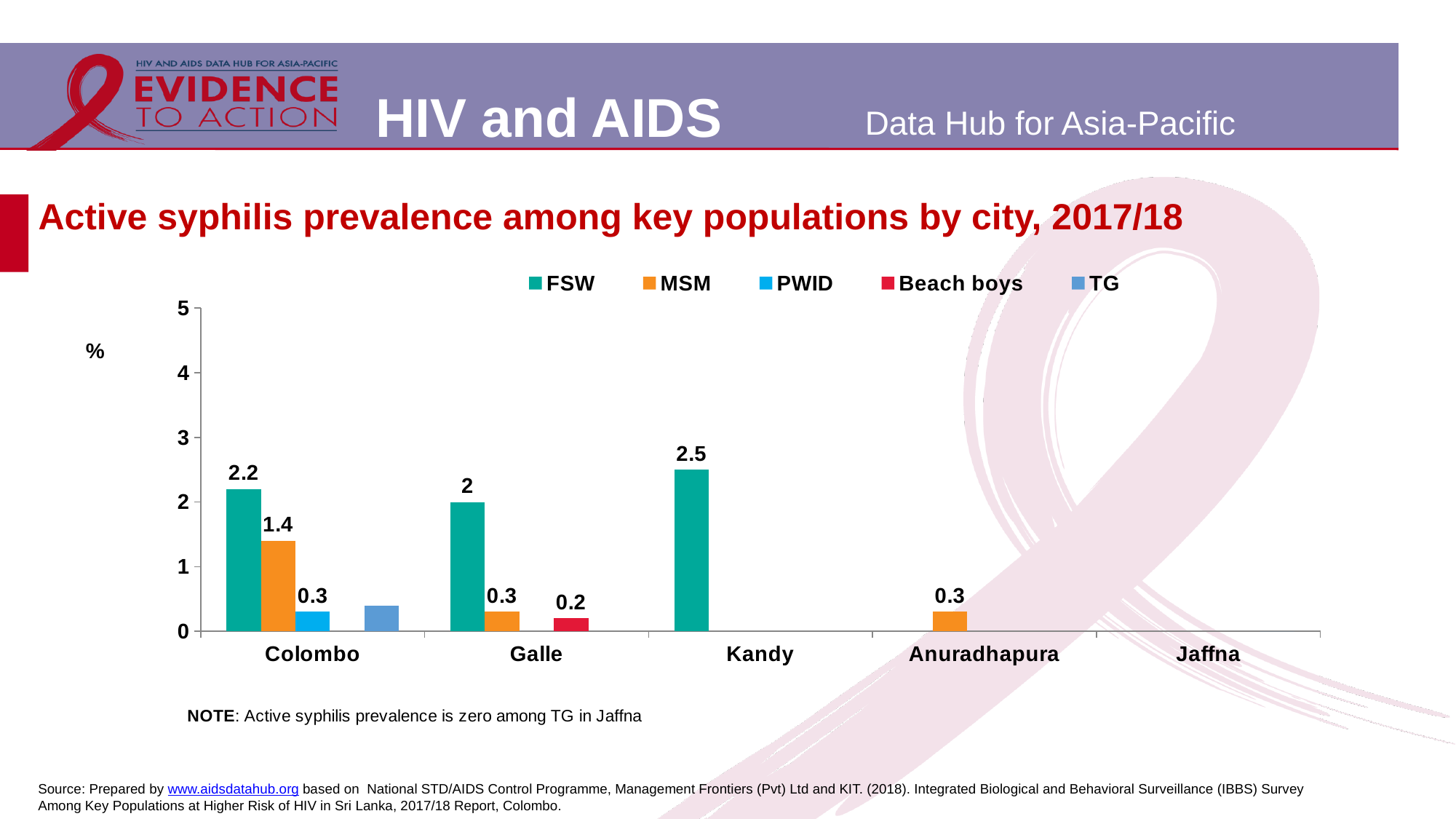
What is the title of the chart? Active syphilis prevalence among key populations by city, 2017/18 What is the active syphilis prevalence among MSM in Colombo? 1.4 What is the active syphilis prevalence among FSW in Kandy? 2.5 How many cities are shown on the x axis of the chart? 5 What is the difference between the FSW and MSM active syphilis prevalence in Colombo? 0.8 Which city has the highest active syphilis prevalence among FSW? Kandy How many series does the legend list? 5 What is the active syphilis prevalence among Beach boys in Galle? 0.2 What kind of chart is shown on the slide? bar chart Which is larger: the FSW prevalence in Colombo or the FSW prevalence in Galle? Colombo What is the active syphilis prevalence among FSW in Colombo? 2.2 Is the value for TG in Colombo greater or less than 1? less